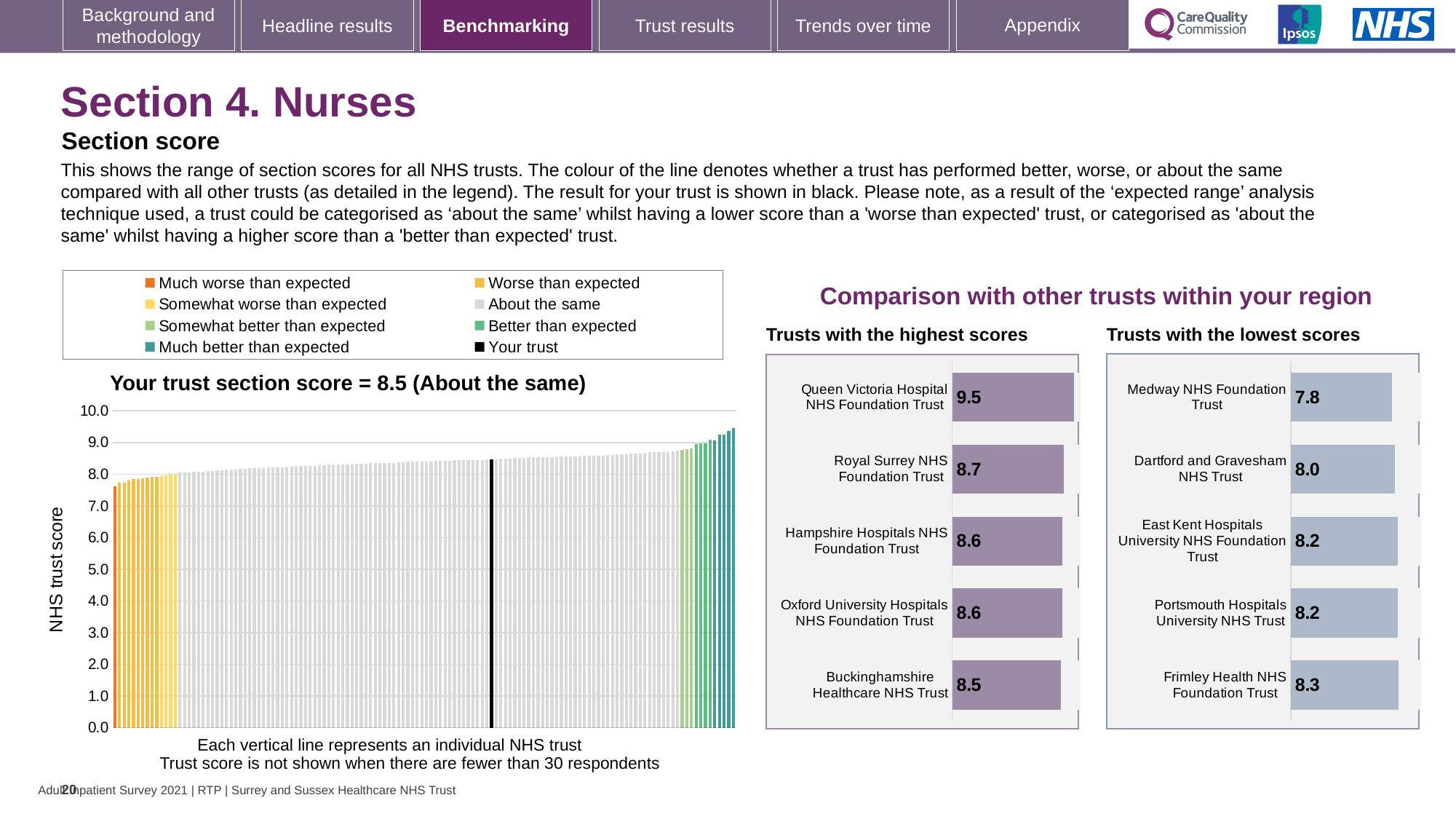
In the 'Trusts with the highest scores' chart, what is the difference between the scores of Queen Victoria Hospital NHS Foundation Trust and Royal Surrey NHS Foundation Trust? 0.8 In the 'Trusts with the lowest scores' chart, which trust has the lowest score? Medway NHS Foundation Trust In the 'Trusts with the highest scores' chart, what is the score for Queen Victoria Hospital NHS Foundation Trust? 9.5 In the 'Trusts with the highest scores' chart, how many trusts are shown? 5 In the 'Your trust section score' chart, what is the section score for your trust? 8.5 In the 'Trusts with the lowest scores' chart, which has the higher score: Dartford and Gravesham NHS Trust or Frimley Health NHS Foundation Trust? Frimley Health NHS Foundation Trust What kind of chart is the 'Your trust section score' chart? Bar chart In the 'Trusts with the lowest scores' chart, what is the score for East Kent Hospitals University NHS Foundation Trust? 8.2 In the 'Trusts with the lowest scores' chart, what is the difference between the scores of Frimley Health NHS Foundation Trust and Medway NHS Foundation Trust? 0.5 In the 'Trusts with the highest scores' chart, which trust has the highest score? Queen Victoria Hospital NHS Foundation Trust In the 'Trusts with the lowest scores' chart, what is the score for Medway NHS Foundation Trust? 7.8 In the 'Your trust section score' chart, do the trust scores rise or fall from left to right along the x axis? Rise